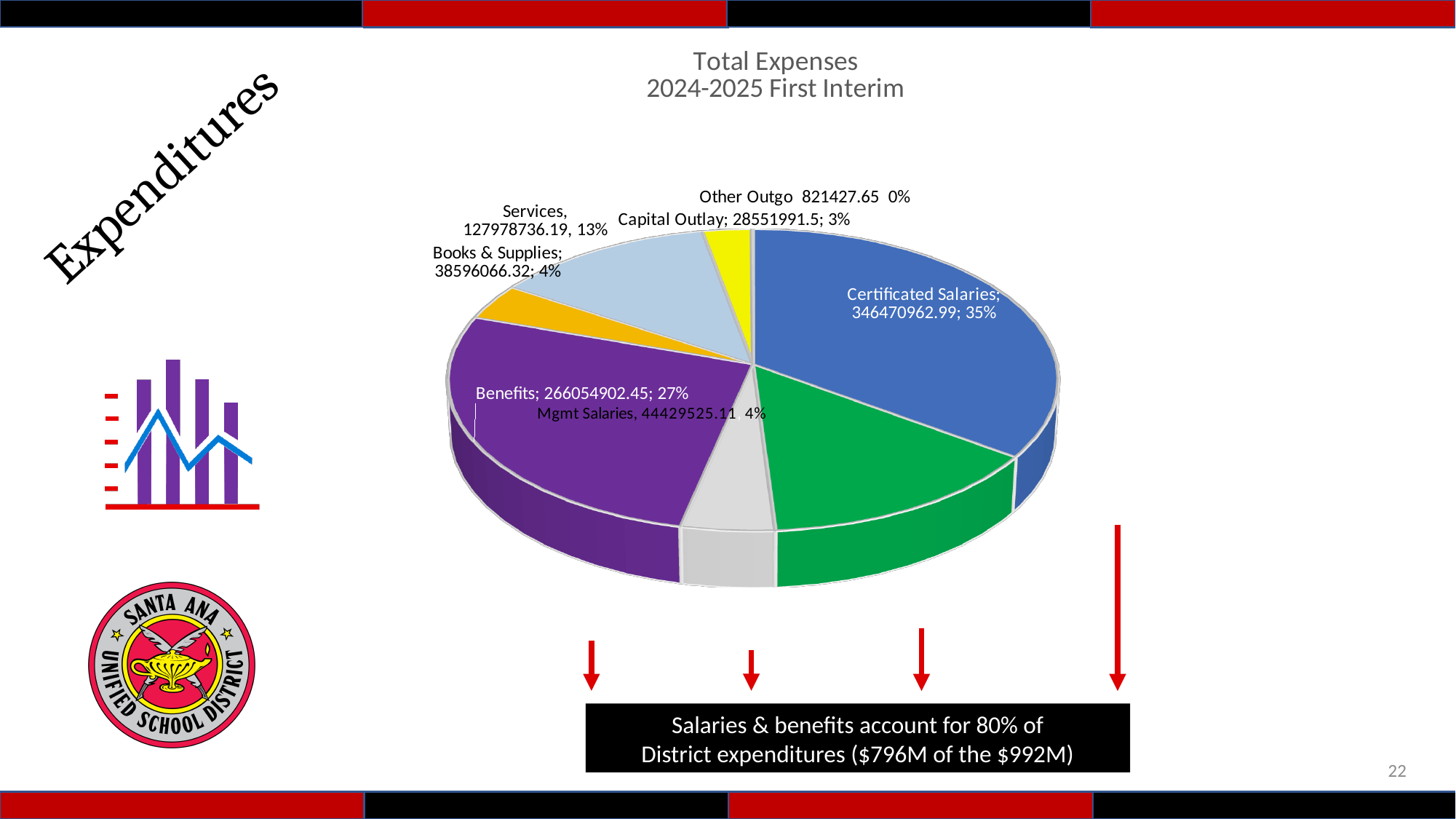
What is the value shown for Certificated Salaries? 346470962.99 What is the value shown for Benefits? 266054902.45 Which is larger, the value for Services or the value for Books & Supplies? Services What is the title of the pie chart? Total Expenses 2024-2025 First Interim Which labeled category has the smallest share of the pie? Other Outgo What is the value shown for Services? 127978736.19 What is the difference in percentage share between Certificated Salaries and Benefits? 8% Which labeled category has the largest share of the pie? Certificated Salaries What kind of chart is shown on the slide? pie chart What share of the pie does Services represent? 13% What share of the pie does Benefits represent? 27% What is the value shown for Capital Outlay? 28551991.5